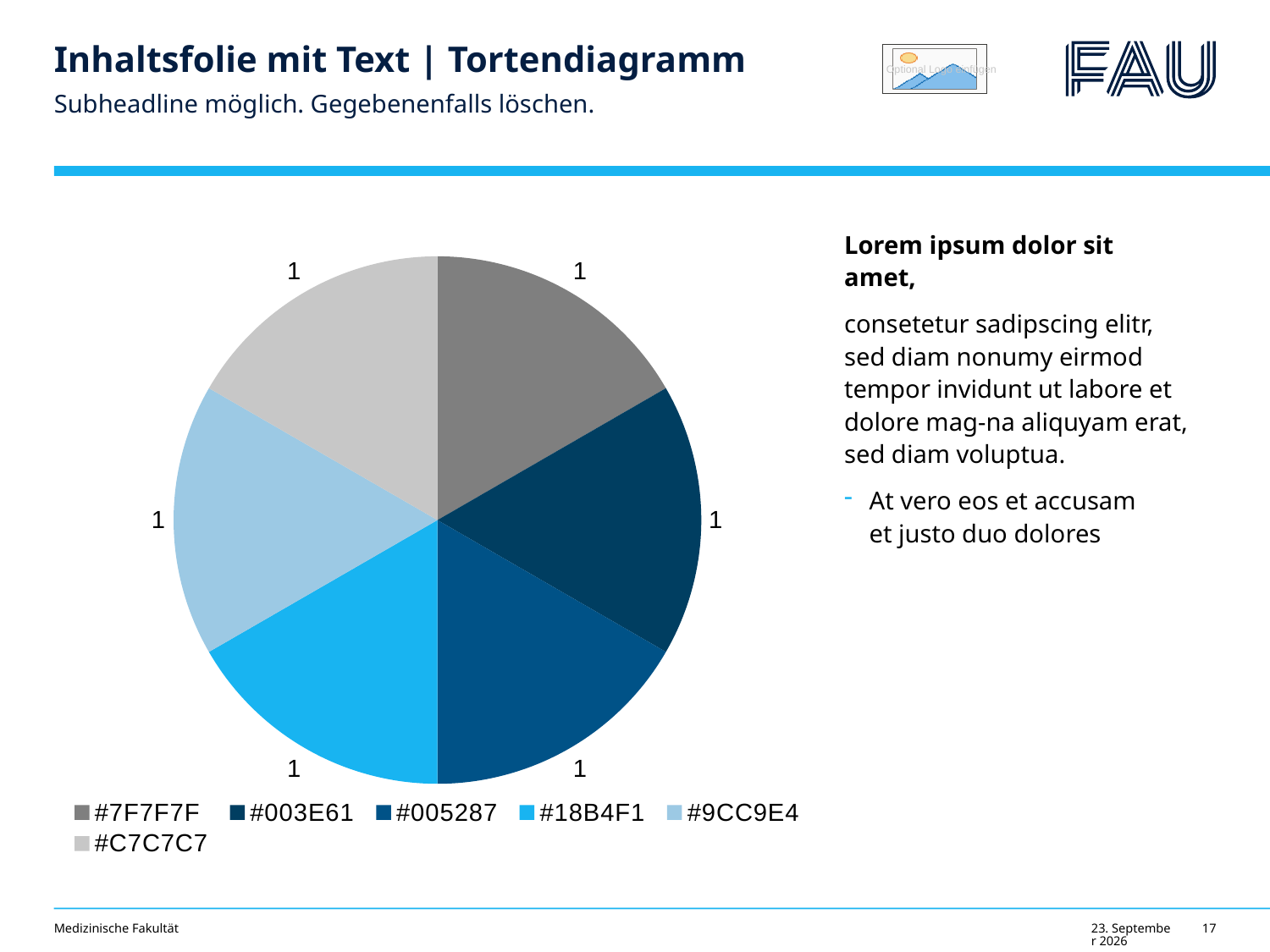
Is the value for #005287 larger than, smaller than, or equal to the value for #7F7F7F? equal How many entries does the legend of the pie chart list? 6 What is the last entry listed in the pie chart's legend? #C7C7C7 What is the total of all the slice values in the pie chart? 6 How many slices does the pie chart have? 6 What is the value shown for the #C7C7C7 slice of the pie chart? 1 What is the difference between the values of the #003E61 and #9CC9E4 slices? 0 Do all slices of the pie chart have the same value? yes What is the first entry listed in the pie chart's legend? #7F7F7F What kind of chart is shown on the slide? pie chart What is the value shown for the #18B4F1 slice of the pie chart? 1 What is the value shown for the #7F7F7F slice of the pie chart? 1